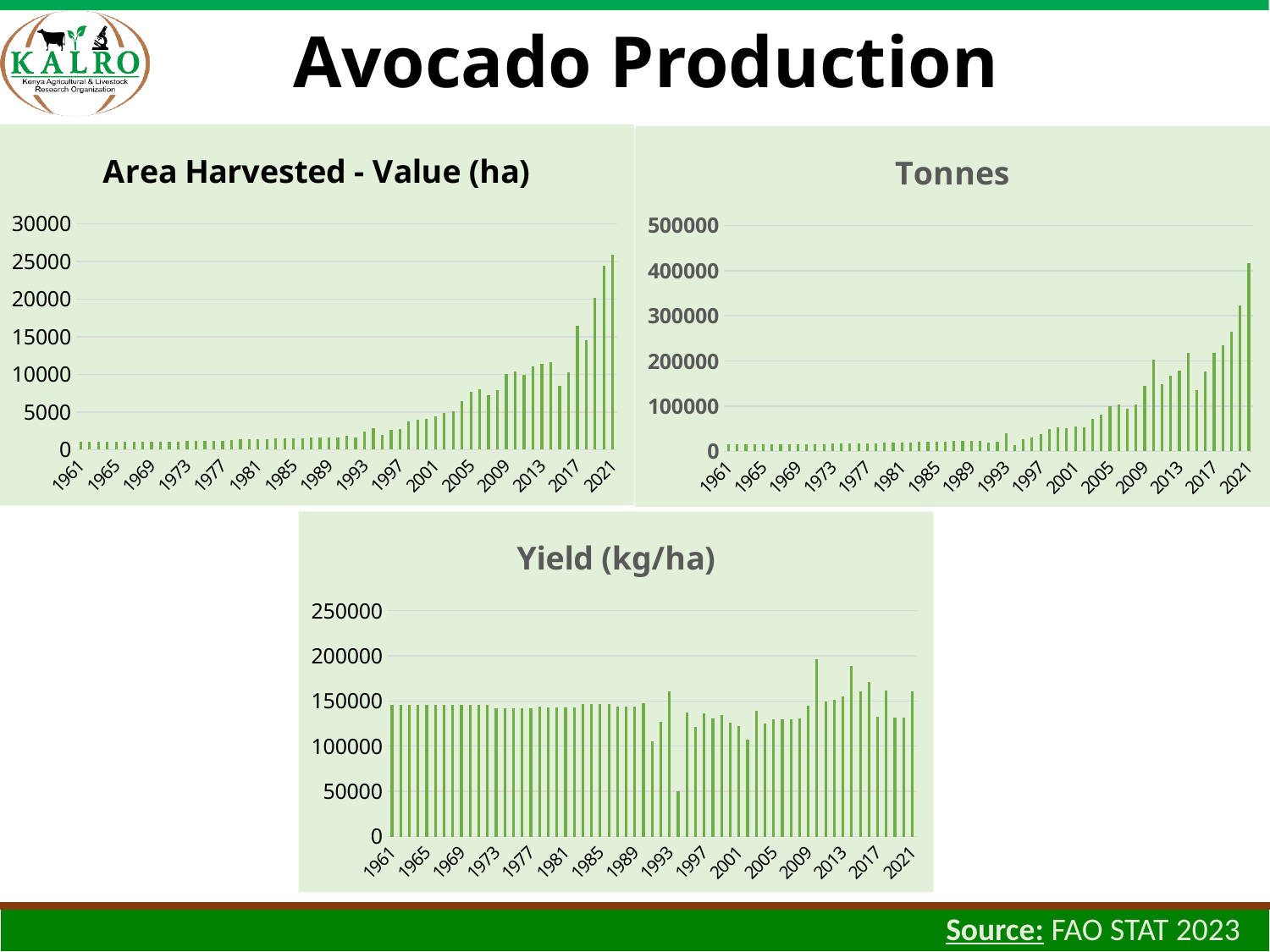
In the 'Tonnes' chart, is the value for 2021 larger or smaller than the value for 2017? larger What is the title of the chart at the bottom of the slide? Yield (kg/ha) In the 'Yield (kg/ha)' chart, is the value for 1961 greater or less than 100000? greater In the 'Tonnes' chart, is the value for 2021 greater or less than 400000? greater In the 'Tonnes' chart, which year has the highest value? 2021 In the 'Area Harvested - Value (ha)' chart, is the value for 2021 greater or less than 25000? greater In the 'Area Harvested - Value (ha)' chart, which year has the highest value? 2021 What is the highest value shown on the y axis of the 'Tonnes' chart? 500000 How many charts are shown on the slide? 3 What kind of chart is the 'Tonnes' chart? bar chart In the 'Area Harvested - Value (ha)' chart, do the values generally rise or fall from 1961 to 2021? rise